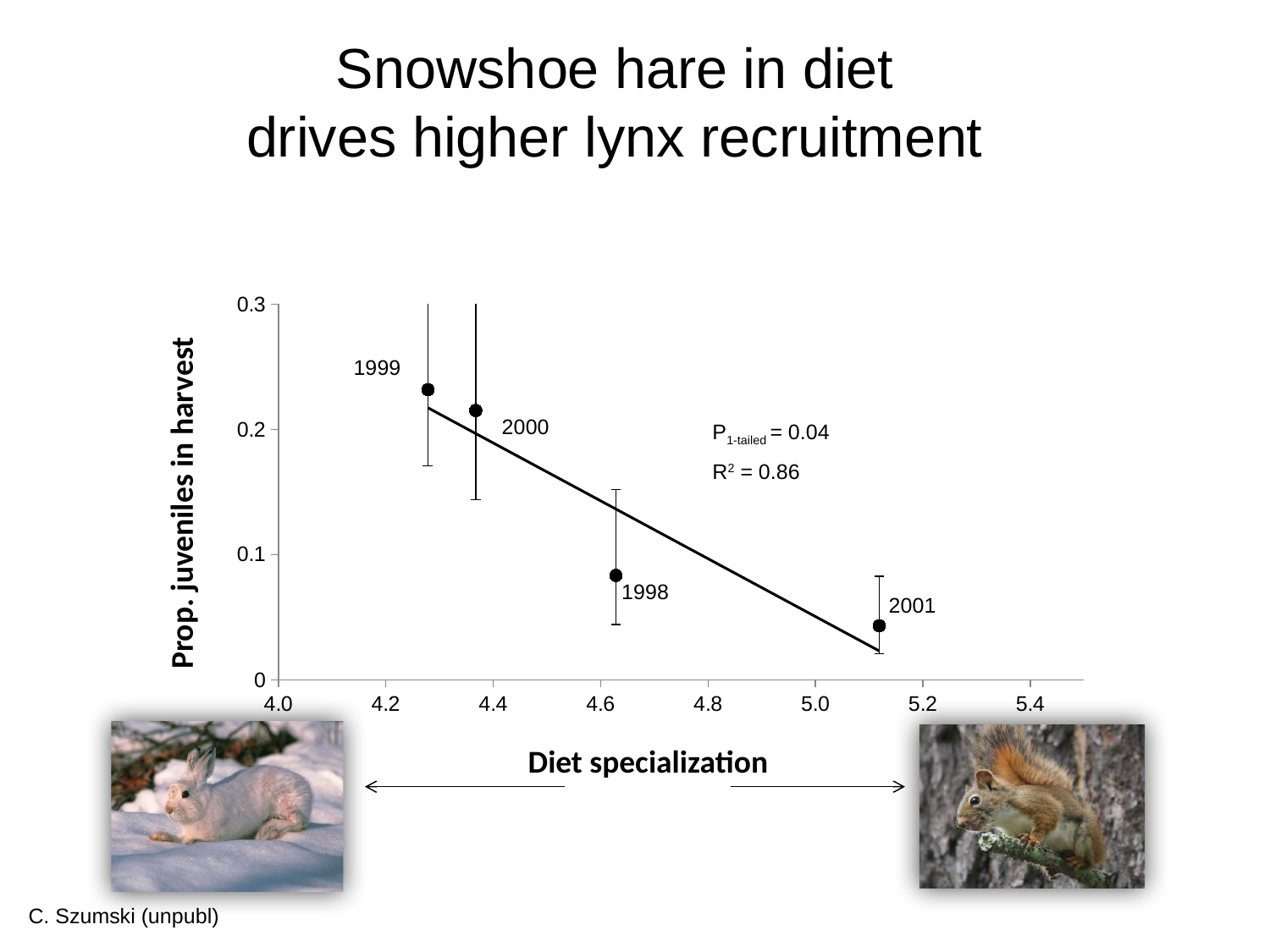
Is the proportion of juveniles in harvest for 1999 greater or less than 0.2? greater What kind of chart is shown on the slide? scatter plot Is the diet specialization value for 2001 greater or less than 5.0? greater Is the proportion of juveniles in harvest for 2001 greater or less than 0.1? less Does the proportion of juveniles in harvest rise or fall as diet specialization increases? fall What is the R² value shown on the chart? 0.86 Which year has a higher proportion of juveniles in harvest, 1999 or 1998? 1999 How many data points are plotted on the chart? 4 What is the label of the y axis? Prop. juveniles in harvest Which year has the lowest proportion of juveniles in harvest? 2001 Which year has the highest proportion of juveniles in harvest? 1999